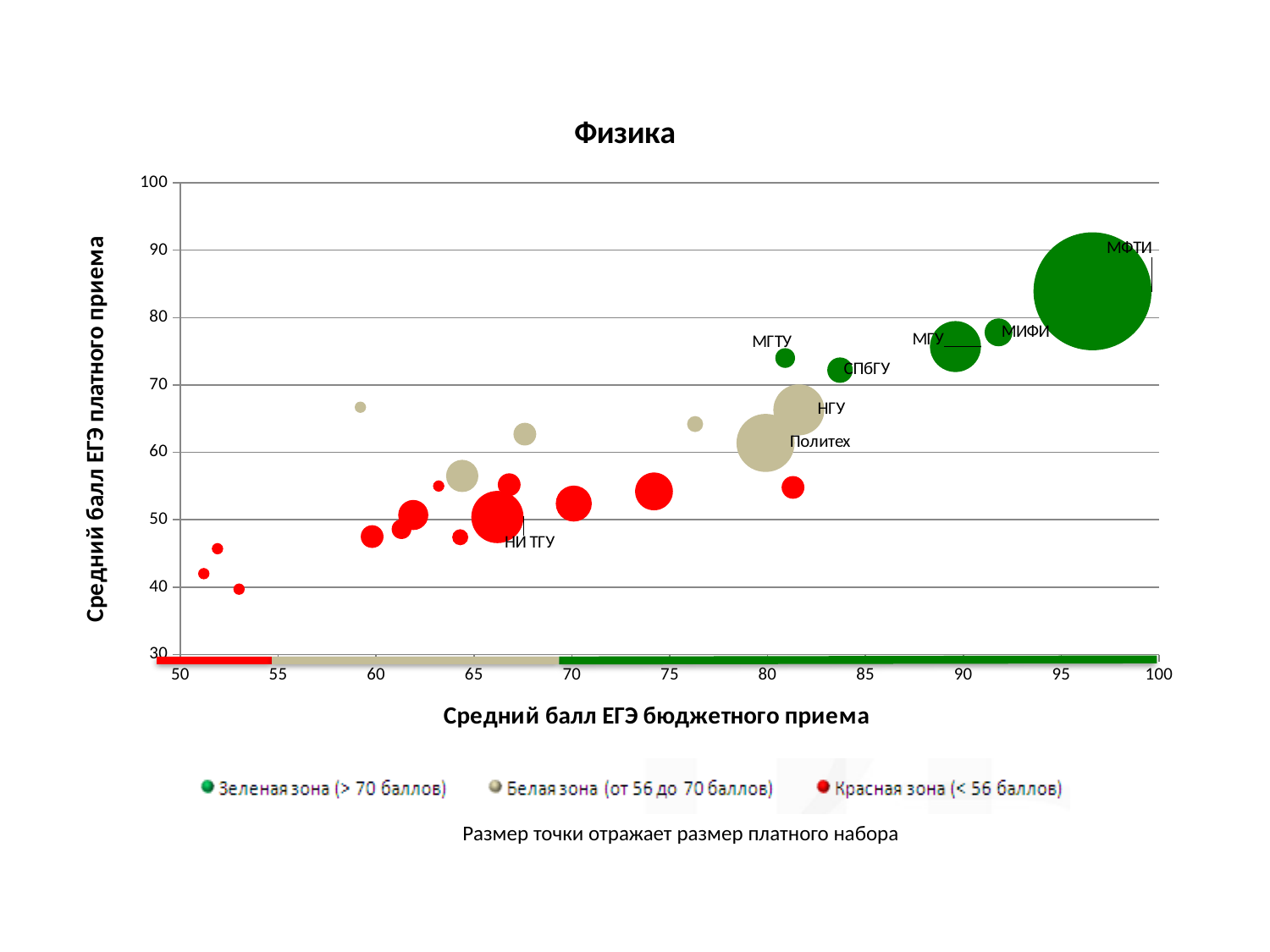
Is the vertical-axis value for МФТИ greater or less than 80? greater Which labeled university has the largest bubble? МФТИ Is the vertical-axis value for МГТУ greater or less than 70? greater Is the vertical-axis value for НИ ТГУ greater or less than 60? less Which labeled university has the highest average paid-admission score (vertical axis)? МФТИ What is the title of the chart? Физика Which has the higher vertical-axis value, МГТУ or НГУ? МГТУ Which has the higher horizontal-axis value, МГУ or СПбГУ? МГУ What kind of chart is shown on the slide? bubble chart How many series does the legend list? 3 What is the label of the horizontal axis? Средний балл ЕГЭ бюджетного приема